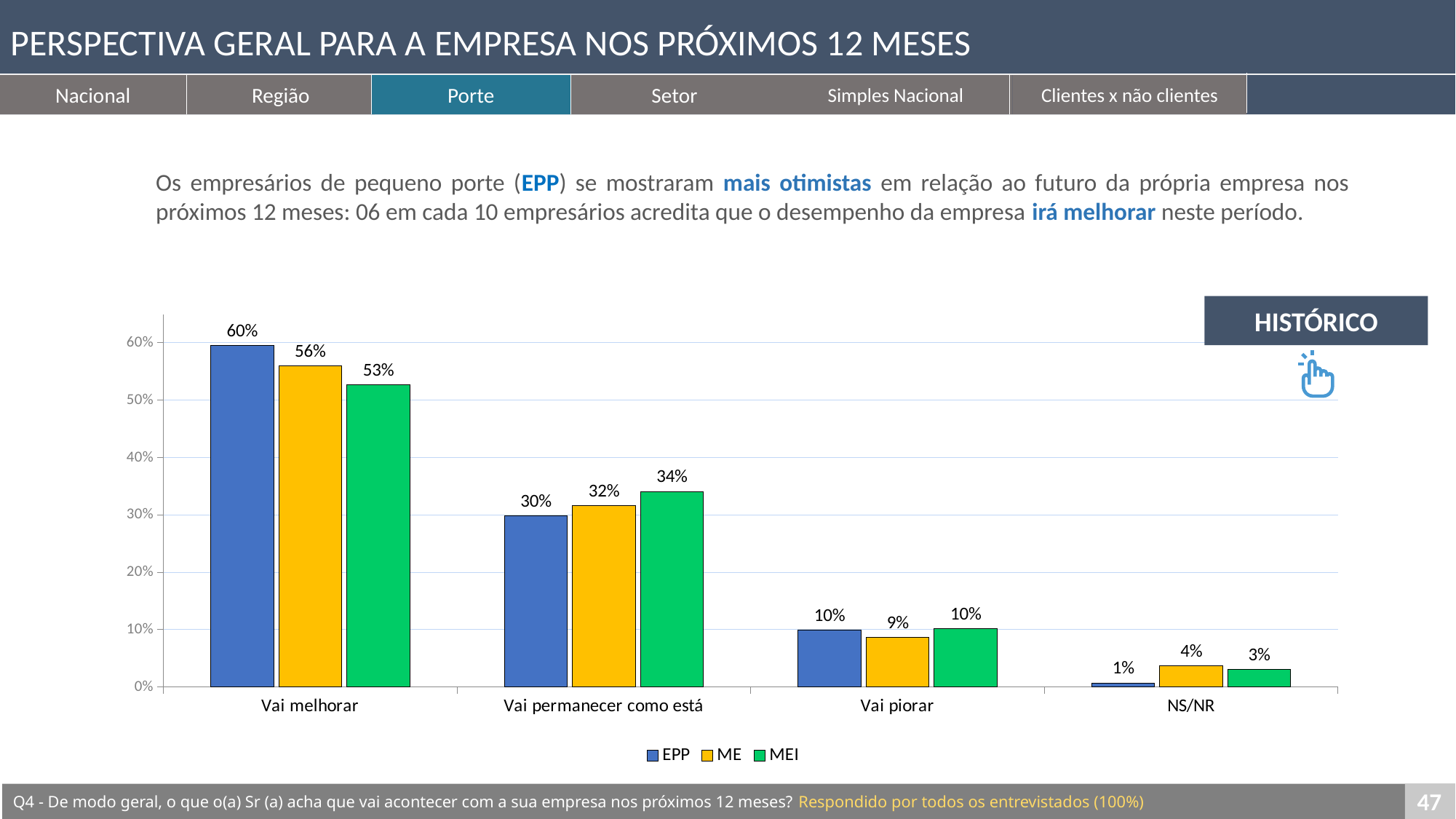
How many categories are shown on the x axis? 4 Which series has the highest value in the 'Vai melhorar' category? EPP What is the difference between the EPP and MEI values in the 'Vai melhorar' category? 7% What is the value for EPP in the 'Vai melhorar' category? 60% Which is larger: the ME value for 'Vai permanecer como está' or the EPP value for 'Vai permanecer como está'? ME Which colour represents the MEI series in the chart? Green What is the value for ME in the 'NS/NR' category? 4% Which series has the lowest value in the 'NS/NR' category? EPP What kind of chart is shown on the slide? Bar chart How many series does the legend list? 3 What is the value for MEI in the 'Vai permanecer como está' category? 34% Is the value for ME in 'Vai melhorar' greater or less than 50%? greater